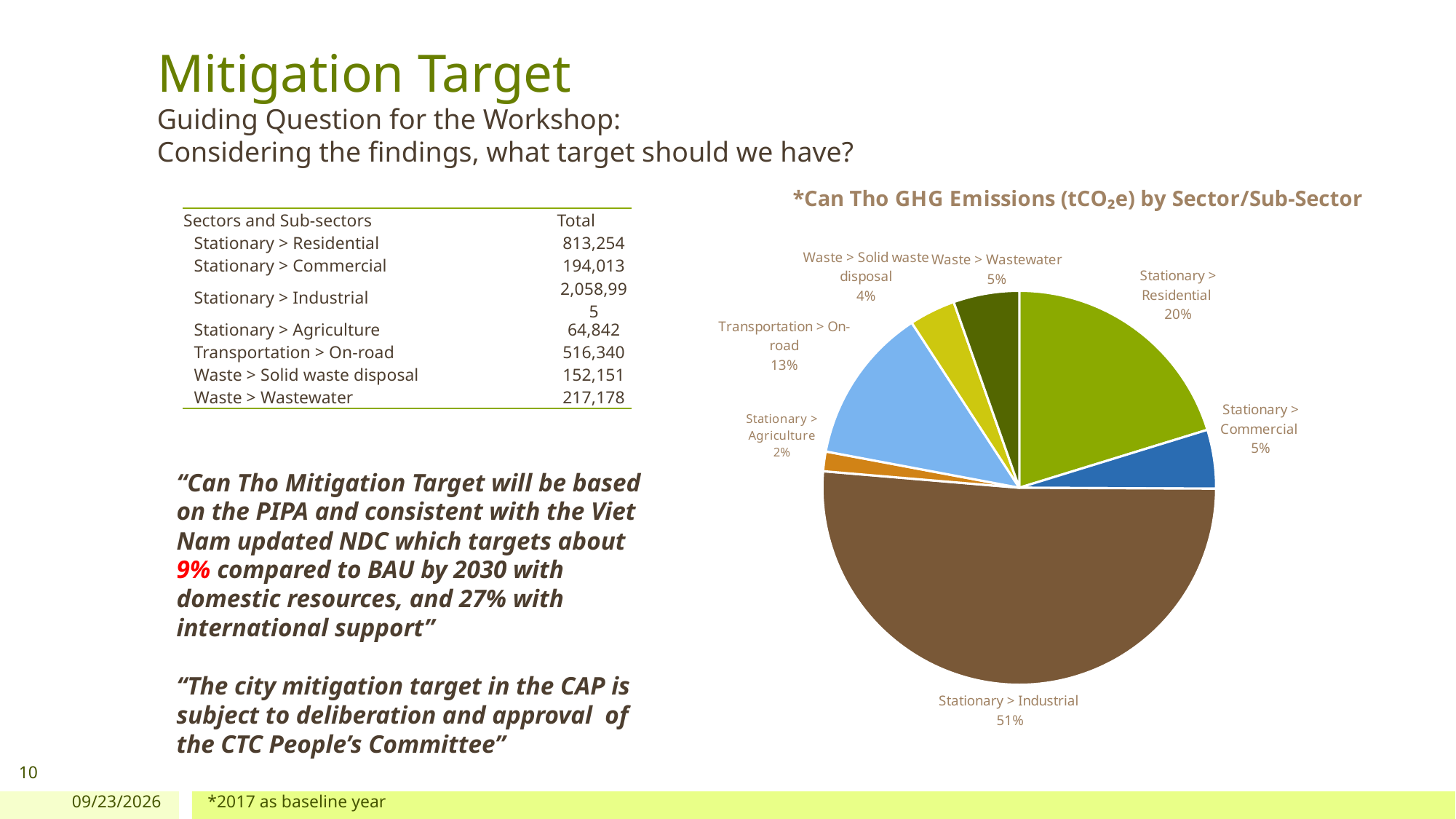
What is the title of the chart? *Can Tho GHG Emissions (tCO₂e) by Sector/Sub-Sector Which sector/sub-sector has the smallest slice of the pie? Stationary > Agriculture What share of the pie does Waste > Solid waste disposal represent? 4% What share of the pie does Stationary > Industrial represent? 51% How many slices does the pie chart have? 7 What share of the pie does Stationary > Residential represent? 20% What is the difference in percentage points between the Stationary > Industrial slice and the Stationary > Residential slice? 31 percentage points Which sector/sub-sector has the largest slice of the pie? Stationary > Industrial What type of chart is shown on the slide? pie chart What colour is the Stationary > Industrial slice? brown Which slice is larger: Stationary > Residential or Transportation > On-road? Stationary > Residential